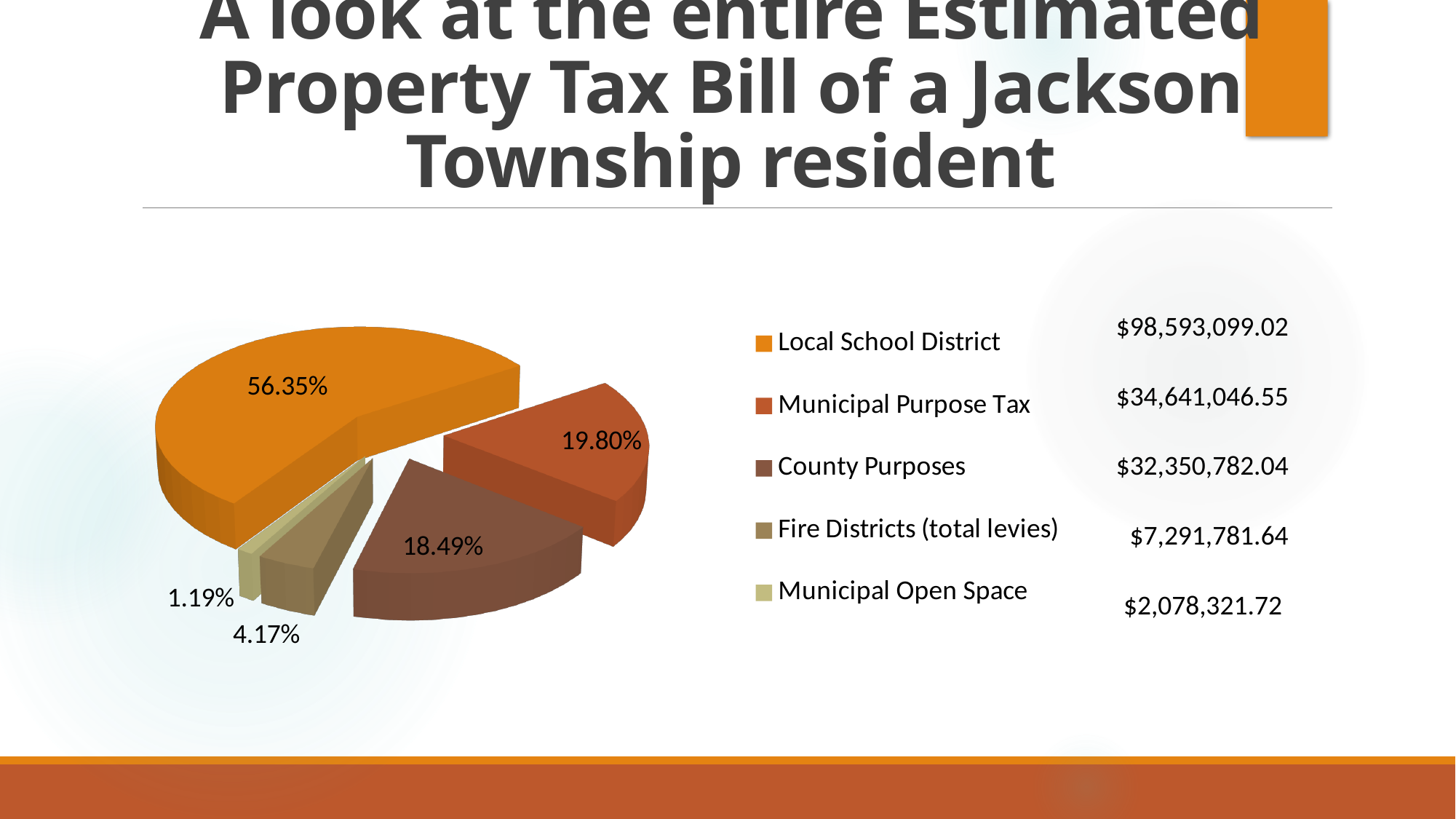
Which category has the largest slice of the pie? Local School District Which is larger, the share for Municipal Purpose Tax or the share for County Purposes? Municipal Purpose Tax How many slices does the pie chart have? 5 What dollar amount is shown for Fire Districts (total levies)? $7,291,781.64 What share of the pie does Fire Districts (total levies) represent? 4.17% What share of the pie does Municipal Purpose Tax represent? 19.80% What share of the pie does Local School District represent? 56.35% Which category has the smallest slice of the pie? Municipal Open Space What dollar amount is shown for Local School District? $98,593,099.02 What kind of chart is shown on the slide? Pie chart